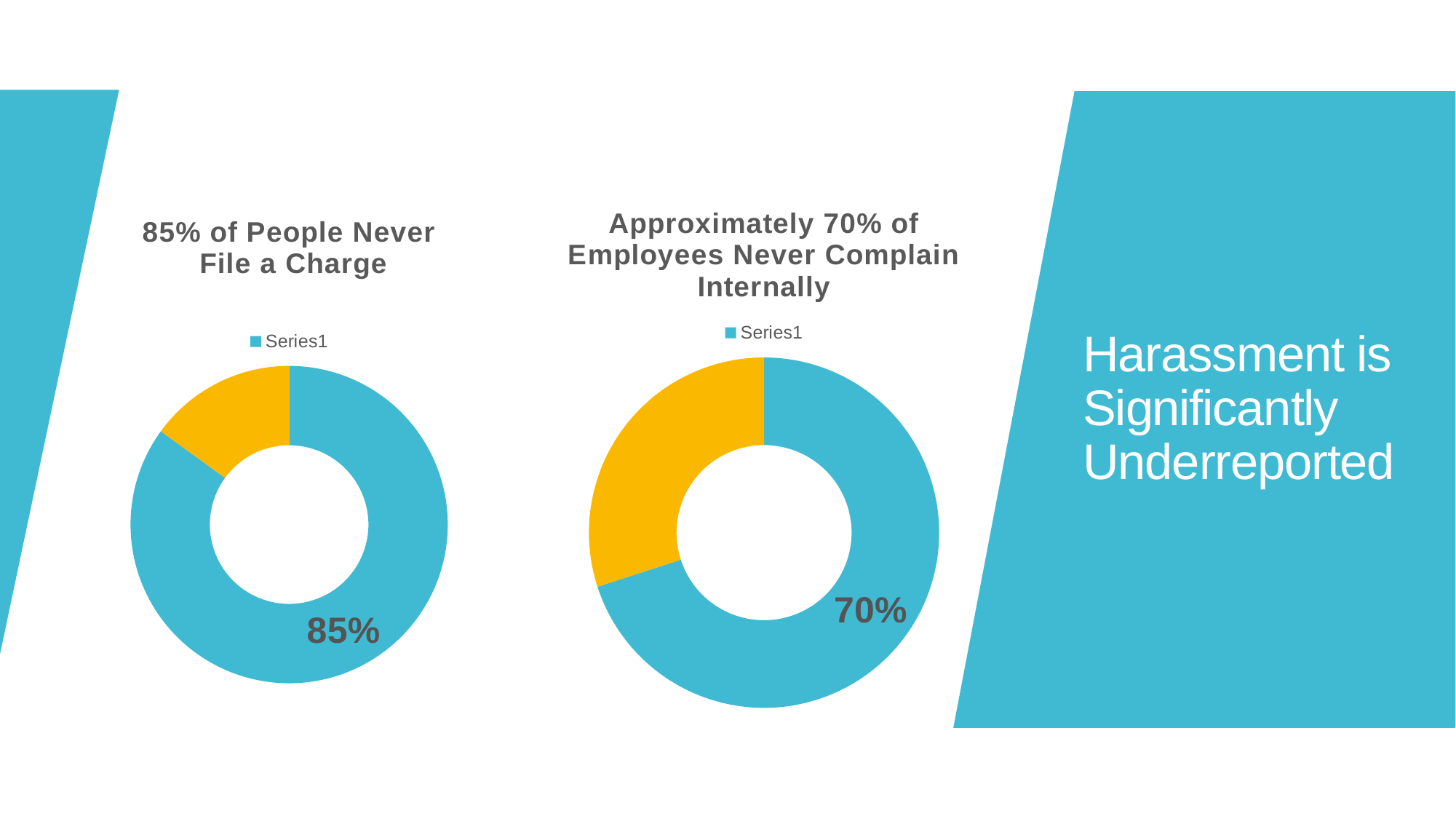
In the right chart, "Approximately 70% of Employees Never Complain Internally", what value is printed on the blue slice? 70% In the left chart, "85% of People Never File a Charge", what value is printed on the blue slice? 85% How many slices does the left chart, "85% of People Never File a Charge", have? 2 How many series does the legend of the left chart, "85% of People Never File a Charge", list? 1 Which chart has the larger labelled blue slice, the left chart ("85% of People Never File a Charge") or the right chart ("Approximately 70% of Employees Never Complain Internally")? The left chart What legend entry is shown above the left chart, "85% of People Never File a Charge"? Series1 What kind of chart is the left chart titled "85% of People Never File a Charge"? Doughnut chart In the right chart, "Approximately 70% of Employees Never Complain Internally", which slice is larger, the blue one or the yellow one? The blue one In the left chart, "85% of People Never File a Charge", which slice is larger, the blue one or the yellow one? The blue one What is the difference between the labelled value in the left chart (85%) and the labelled value in the right chart (70%)? 15% How many slices does the right chart, "Approximately 70% of Employees Never Complain Internally", have? 2 What is the title of the right chart? Approximately 70% of Employees Never Complain Internally